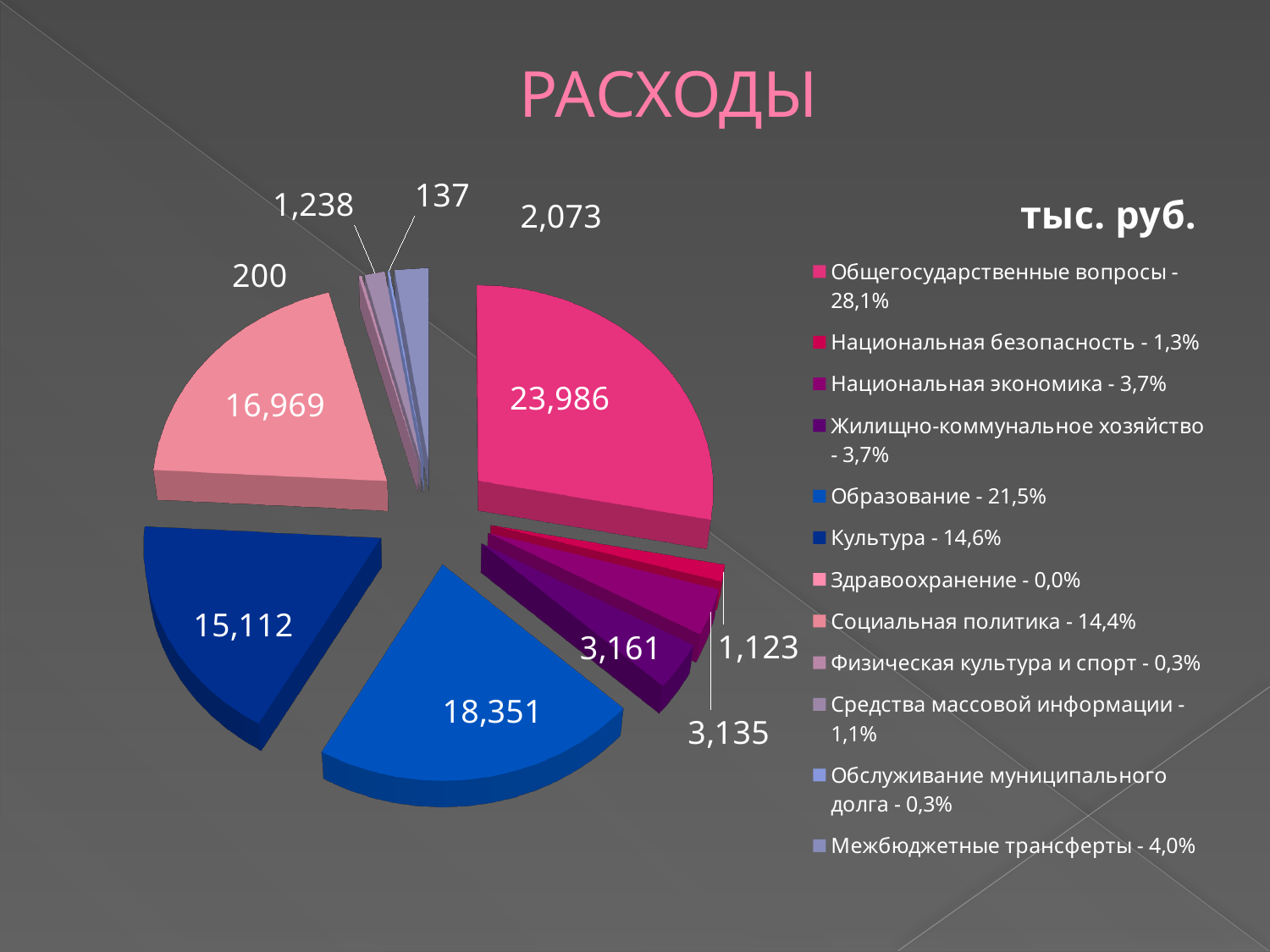
What is the value for Образование? 18,351 What share of the pie does Межбюджетные трансферты represent, according to the legend? 4,0% What is the title of the chart? тыс. руб. Which is larger, the value for Социальная политика or the value for Культура? Социальная политика Which category has the largest slice? Общегосударственные вопросы What kind of chart is shown on the slide? pie chart What is the difference between the values for Образование and Культура? 3,239 What is the value for Общегосударственные вопросы? 23,986 What is the value for Культура? 15,112 What share of the pie does Образование represent, according to the legend? 21,5% What is the value for Социальная политика? 16,969 How many categories does the legend list? 12